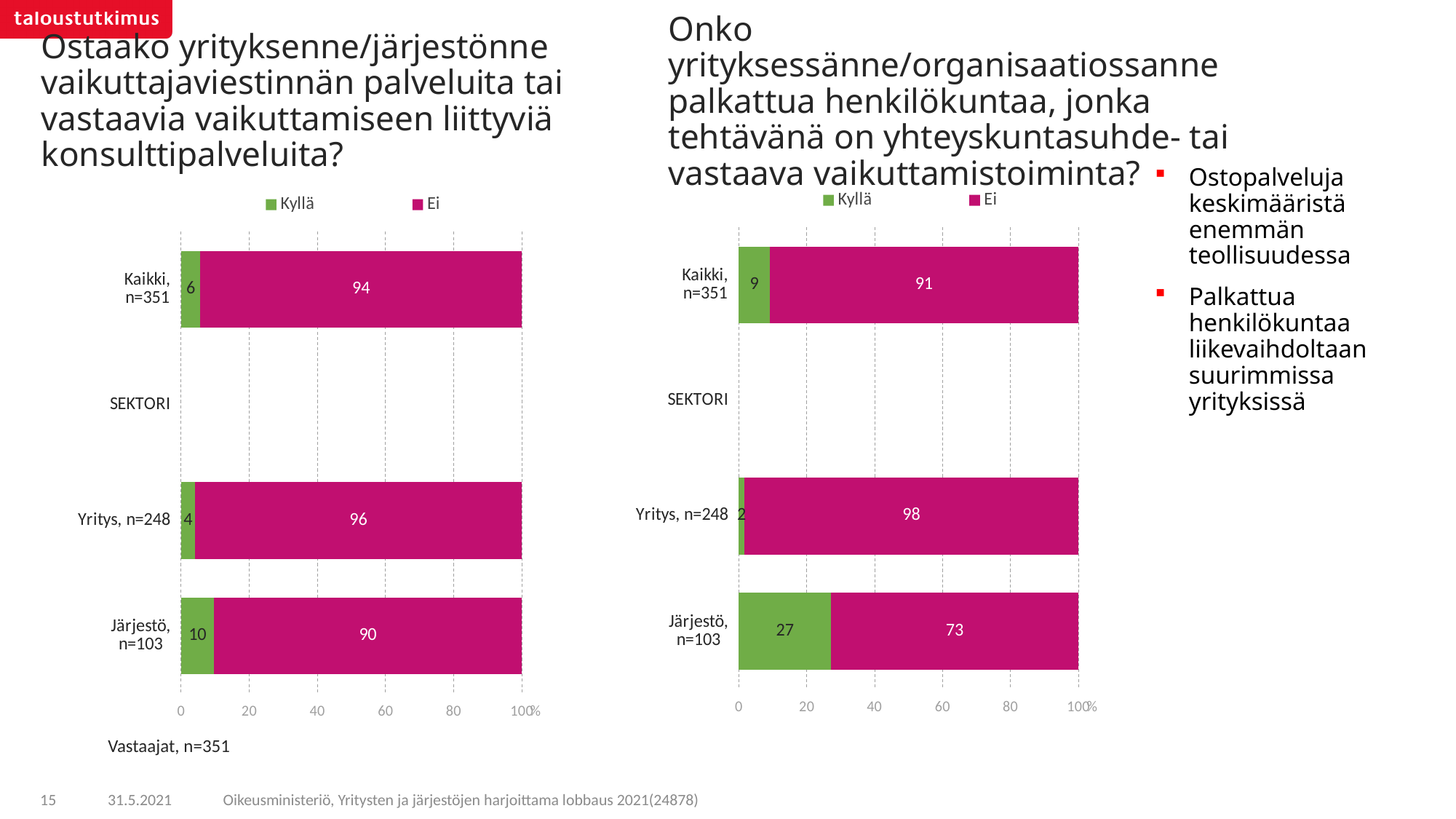
How many series does the legend of the left chart list? 2 In the right chart, what is the Ei value for Kaikki, n=351? 91 What kind of chart is the right chart? Stacked bar chart In the left chart, what is the Kyllä value for Kaikki, n=351? 6 In the right chart, is the Ei value for Järjestö, n=103 greater or less than 80? less In the left chart, which category has the highest Kyllä value? Järjestö, n=103 In the left chart, which is larger: the Kyllä value for Järjestö, n=103 or the Kyllä value for Yritys, n=248? Järjestö, n=103 In the right chart, what is the difference between the Ei values for Yritys, n=248 and Järjestö, n=103? 25 In the left chart, what is the Ei value for Yritys, n=248? 96 In the right chart, what is the Kyllä value for Järjestö, n=103? 27 In the right chart, what is the total of the stacked bar for Kaikki, n=351? 100 In the right chart, which category has the lowest Kyllä value? Yritys, n=248